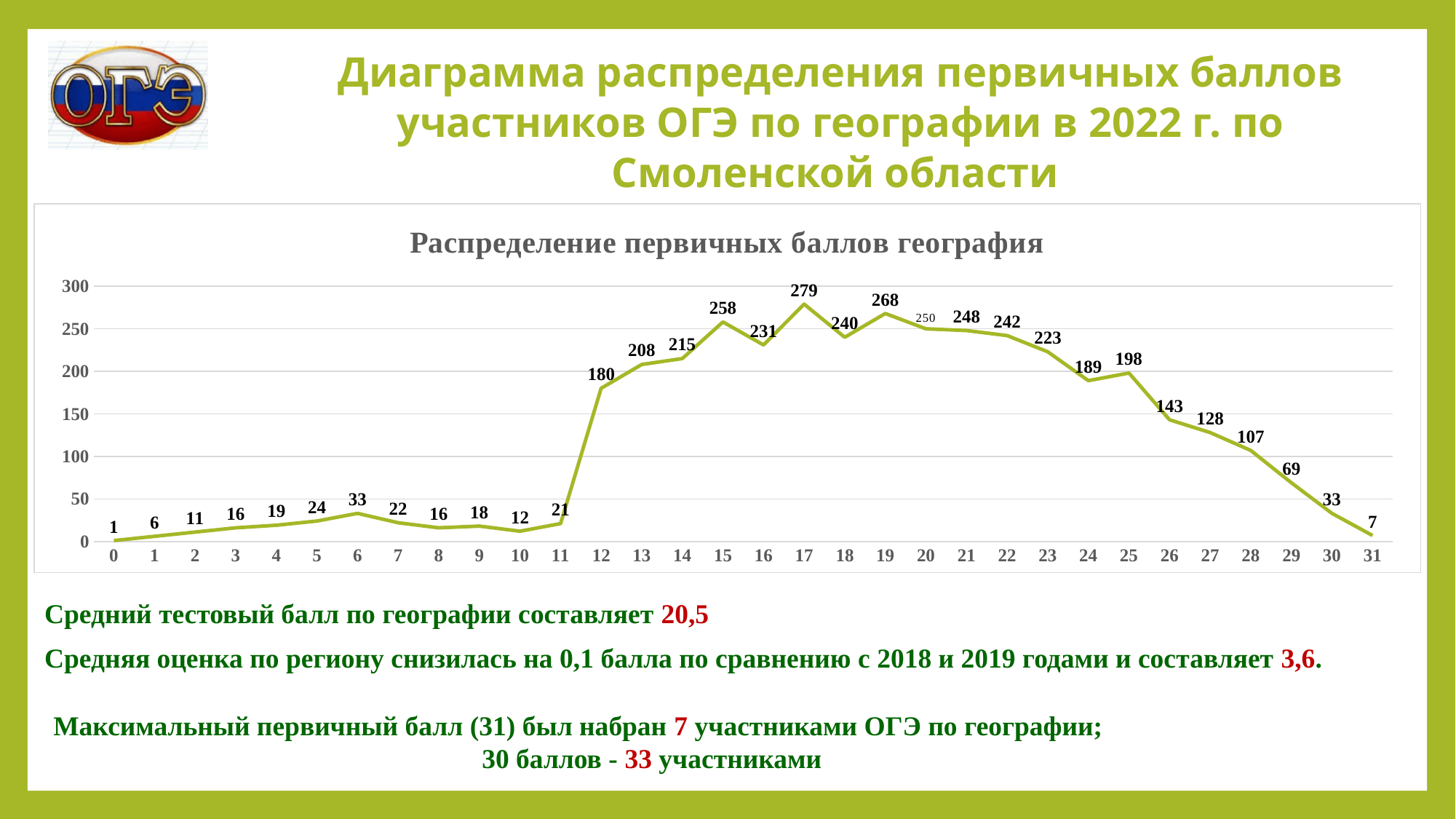
How many primary score points are plotted on the x axis? 32 Do the values rise or fall along the x axis from score 25 to score 31? fall What is the value for a primary score of 12? 180 How many participants scored 17 primary points? 279 Which primary score has the highest number of participants? 17 What is the title of the chart? Распределение первичных баллов география Which has a larger value: score 19 or score 18? 19 What is the value for a primary score of 31? 7 What type of chart is shown on the slide? line chart Which primary score has the lowest number of participants? 0 Is the value for score 26 greater or less than 150? less What is the difference between the values for scores 15 and 16? 27